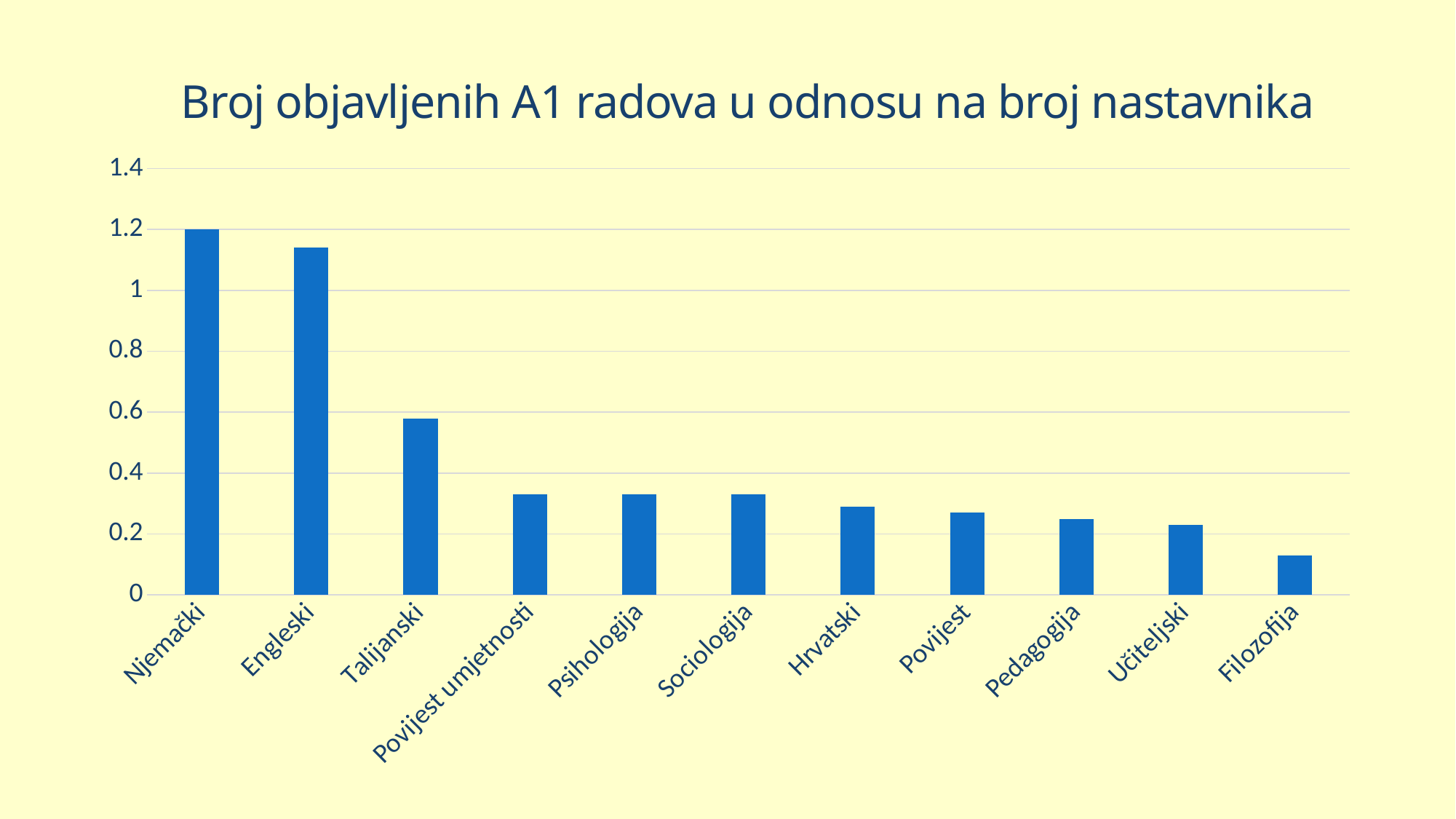
Do the values generally rise or fall from left to right along the x axis? fall What type of chart is shown on the slide? bar chart Which is larger, the value for Talijanski or the value for Psihologija? Talijanski Is the value for Talijanski greater or less than 0.6? less What is the value for Njemački? 1.2 Is the value for Engleski greater or less than 1? greater Which category has the lowest value? Filozofija What is the title of the chart? Broj objavljenih A1 radova u odnosu na broj nastavnika Is the value for Filozofija greater or less than 0.2? less How many categories are shown on the x axis? 11 Which category has the highest value? Njemački